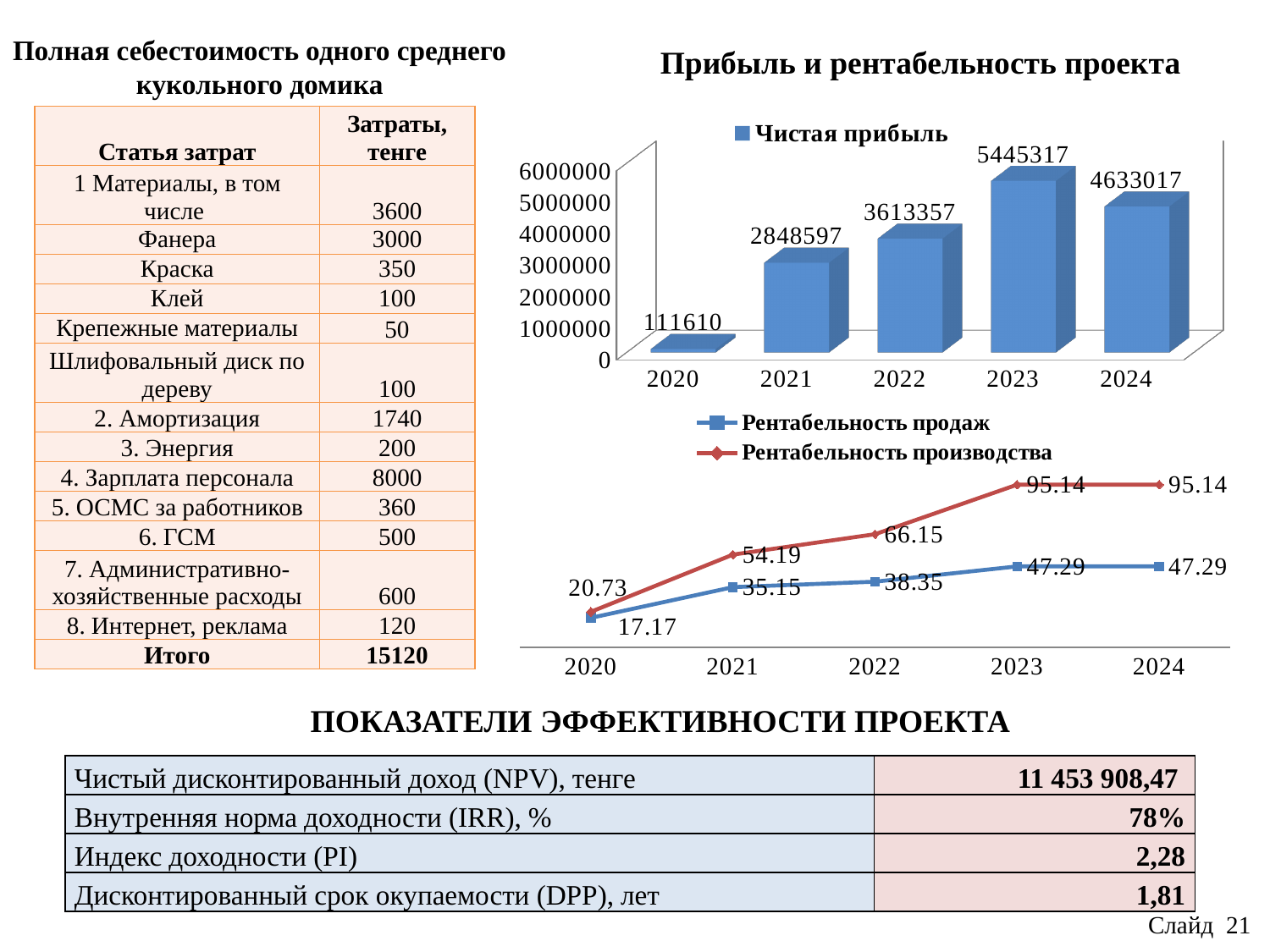
In the bar chart titled "Чистая прибыль", what is the difference between the values for 2023 and 2024? 812300 In the bar chart titled "Чистая прибыль", which year has the highest value? 2023 In the line chart at the lower right, does "Рентабельность производства" rise or fall from 2020 to 2023? rise In the bar chart titled "Чистая прибыль", how many years are shown on the x axis? 5 In the line chart at the lower right, what is the value of "Рентабельность производства" for 2022? 66.15 In the line chart at the lower right, which series has the larger value in 2023, "Рентабельность продаж" or "Рентабельность производства"? Рентабельность производства In the bar chart titled "Чистая прибыль", what is the value for 2020? 111610 In the bar chart titled "Чистая прибыль", what is the value for 2023? 5445317 What kind of chart is the upper chart on the right side of the slide? bar chart In the line chart at the lower right, what is the value of "Рентабельность продаж" for 2020? 17.17 In the bar chart titled "Чистая прибыль", which year has the lowest value? 2020 In the line chart at the lower right, how many series does the legend list? 2